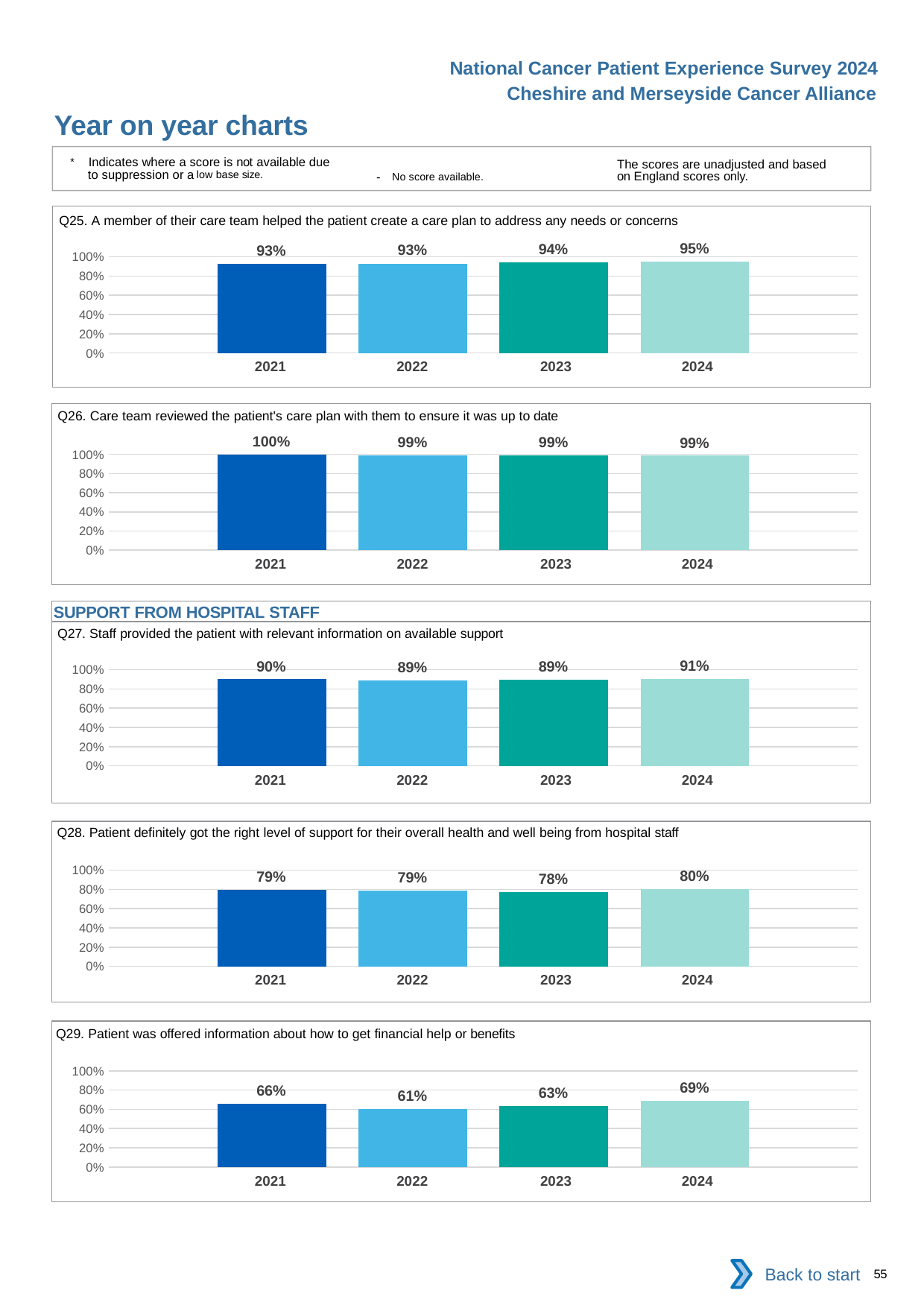
In the Q27 chart, what is the value for 2021? 90% How many charts are shown on the slide? 5 In the Q29 chart, is the value for 2021 greater or less than 80%? less How many years are shown in the Q28 chart? 4 In the Q29 chart, which year has the lowest value? 2022 What kind of chart is the Q26 chart? bar chart In the Q25 chart, what is the value for 2024? 95% In the Q26 chart, which year has the highest value? 2021 In the Q25 chart, do the values rise or fall from 2022 to 2024? rise In the Q28 chart, what is the value for 2023? 78% In the Q29 chart, what is the difference between the 2024 value and the 2022 value? 8% In the Q28 chart, which is larger, the value for 2023 or the value for 2024? 2024